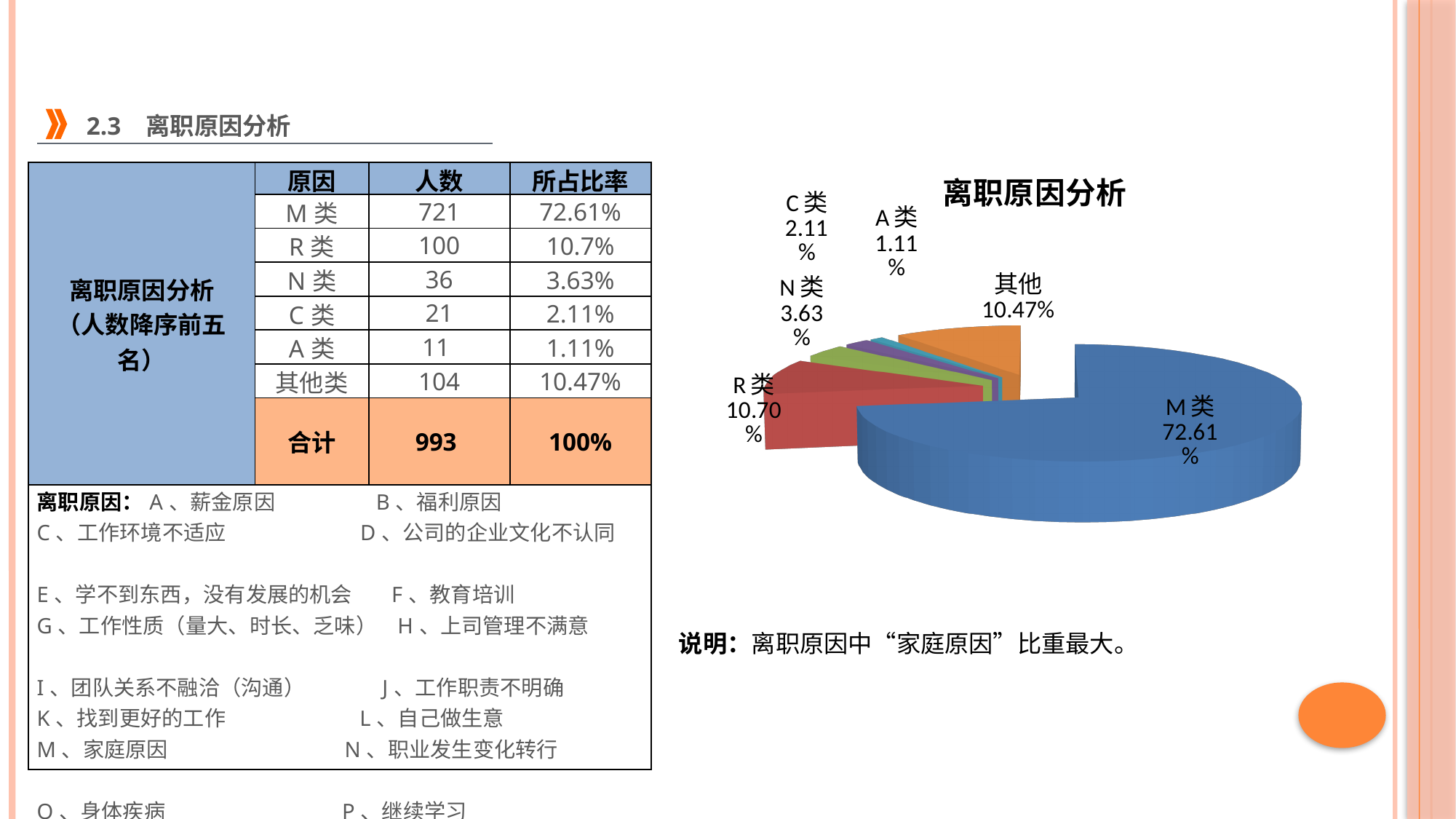
What share of the pie does A类 have? 1.11% What is the title of the pie chart? 离职原因分析 What share of the pie does 其他 have? 10.47% Which slice of the pie chart is the largest? M类 What share of the pie does N类 have? 3.63% How many slices does the pie chart have? 6 What is the difference in percentage points between the M类 slice and the R类 slice? 61.91 What type of chart is shown on the slide? pie chart Which slice of the pie chart is the smallest? A类